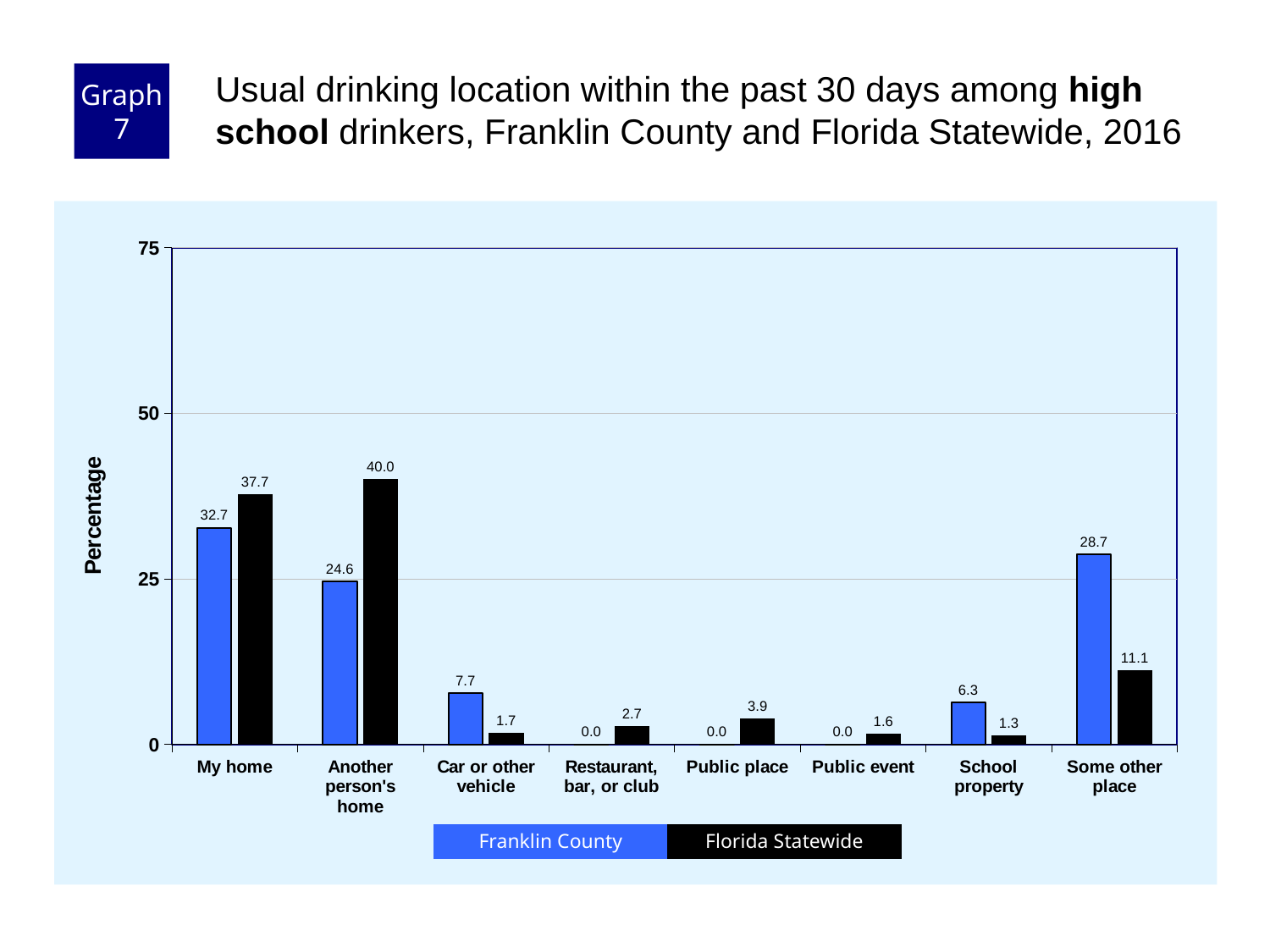
What is the difference between the Florida Statewide and Franklin County values for My home? 5.0 Which category has the lowest Florida Statewide value? School property How many series does the legend list? 2 What kind of chart is shown? bar chart What colour represents Florida Statewide in the legend? black Is the Franklin County value for Another person's home greater or less than 25? less Which is larger for Some other place: Franklin County or Florida Statewide? Franklin County How many location categories are shown on the x axis? 8 Which category has the highest Florida Statewide value? Another person's home What is the Franklin County value for My home? 32.7 What is the Florida Statewide value for Another person's home? 40.0 What is the Franklin County value for Some other place? 28.7